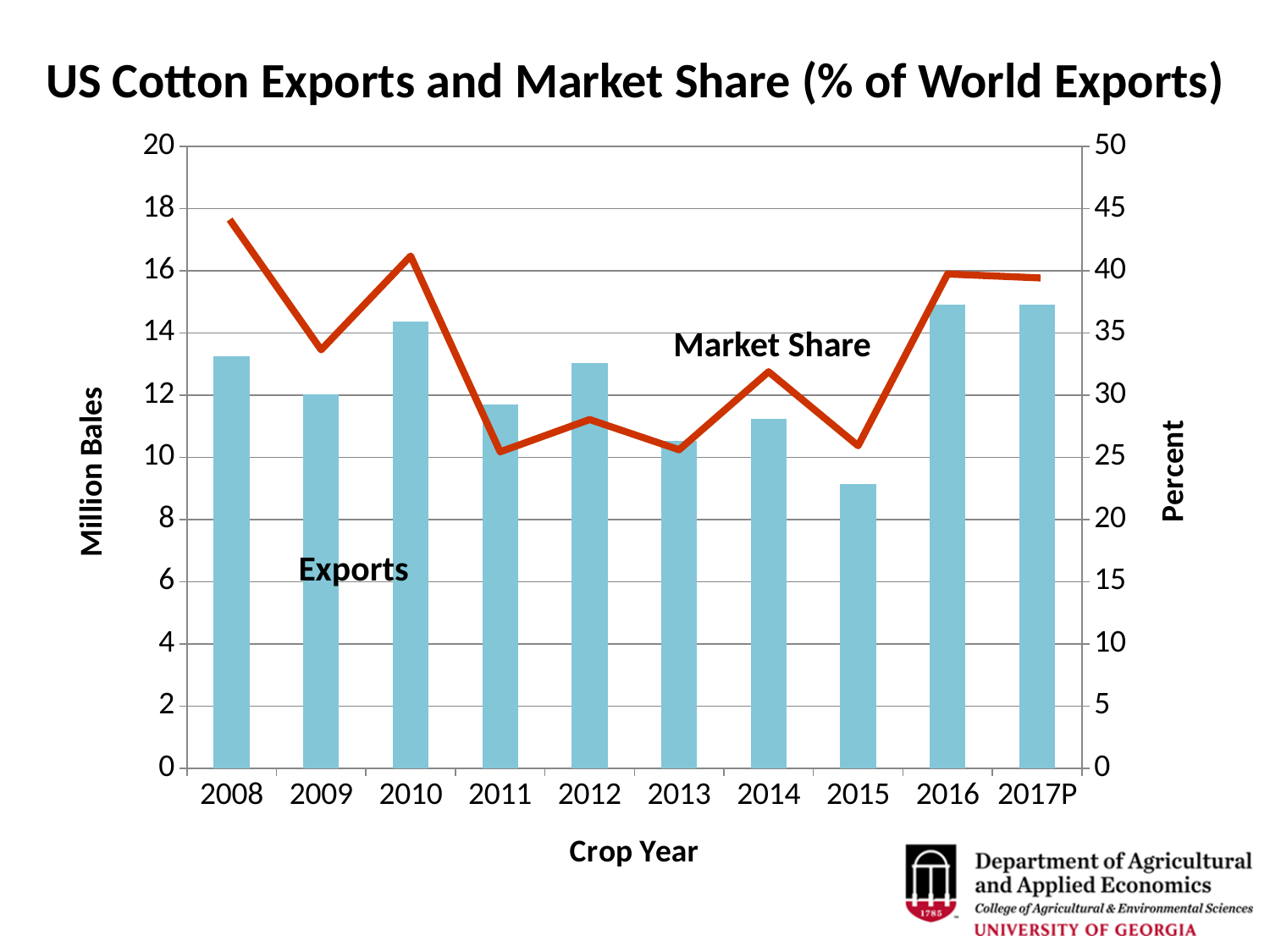
Is the Exports value for 2016 greater or less than 14 million bales? greater What kind of chart is shown on the slide? A combination bar and line chart What is the title of the left vertical axis? Million Bales Is the Exports value for 2015 greater or less than 10 million bales? less Is the Market Share value for 2011 greater or less than 30 percent? less How many crop years are shown on the x axis? 10 Does Market Share rise or fall from 2014 to 2015? fall Which crop year has the lowest Exports bar? 2015 In which crop year is Market Share highest? 2008 Which crop year has higher Exports, 2009 or 2010? 2010 How many data series are plotted on the chart? 2